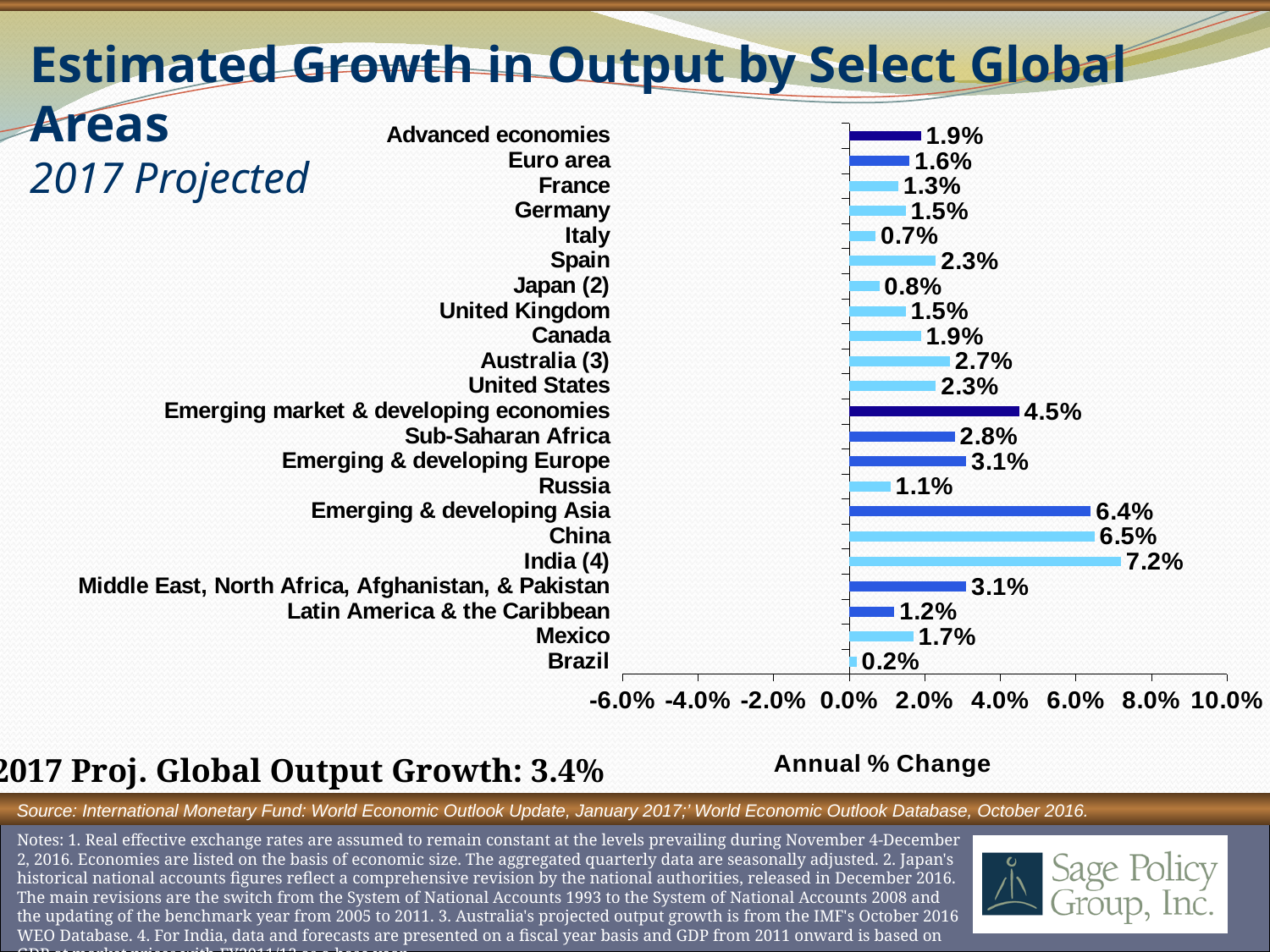
How many areas are plotted in the chart? 22 What kind of chart is shown on the slide? Bar chart What is the projected 2017 output growth for Emerging market & developing economies? 4.5% What is the label on the horizontal axis of the chart? Annual % Change Is the projected growth for Emerging & developing Asia greater or less than 4.0%? greater What is the projected 2017 output growth for China? 6.5% What is the difference between the projected growth for Spain and Italy? 1.6% Which area has the lowest projected 2017 output growth? Brazil What is the difference between the projected growth for India (4) and China? 0.7% What is the projected 2017 output growth for Germany? 1.5% Which has higher projected 2017 output growth, Australia (3) or Canada? Australia (3) Which area has the highest projected 2017 output growth? India (4)